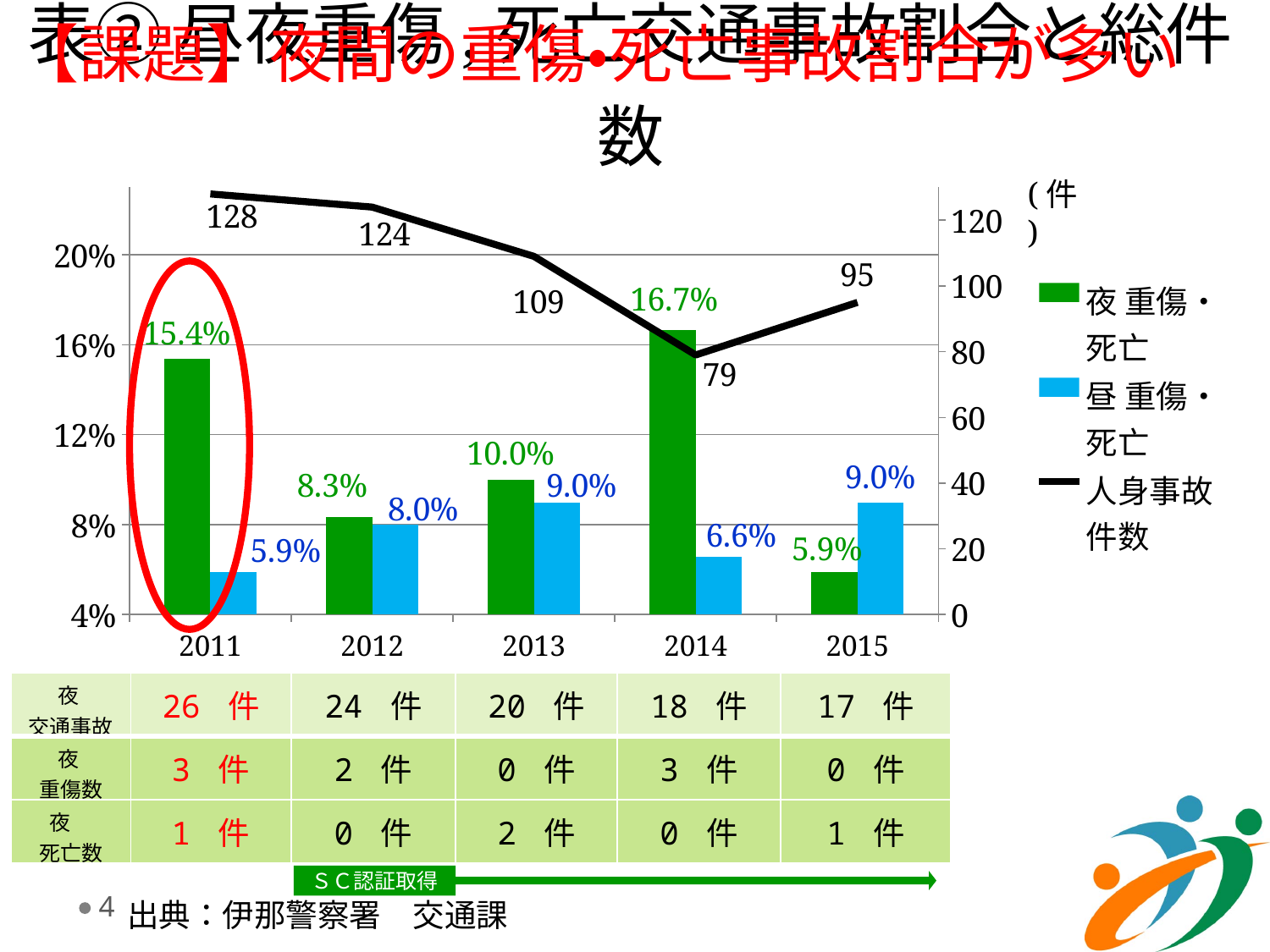
How many series does the legend list? 3 What is the 人身事故件数 value for 2013? 109 What colour are the 夜 重傷・死亡 bars? green Does 人身事故件数 rise or fall from 2011 to 2014? fall In which year is 夜 重傷・死亡 highest? 2014 What is the value of 昼 重傷・死亡 for 2014? 6.6% How many years are shown on the x axis? 5 What is the difference in 人身事故件数 between 2011 and 2015? 33 Which is larger in 2015, 夜 重傷・死亡 or 昼 重傷・死亡? 昼 重傷・死亡 What is the value of 夜 重傷・死亡 for 2011? 15.4% In which year is 人身事故件数 lowest? 2014 What is the difference between 夜 重傷・死亡 and 昼 重傷・死亡 in 2011? 9.5%